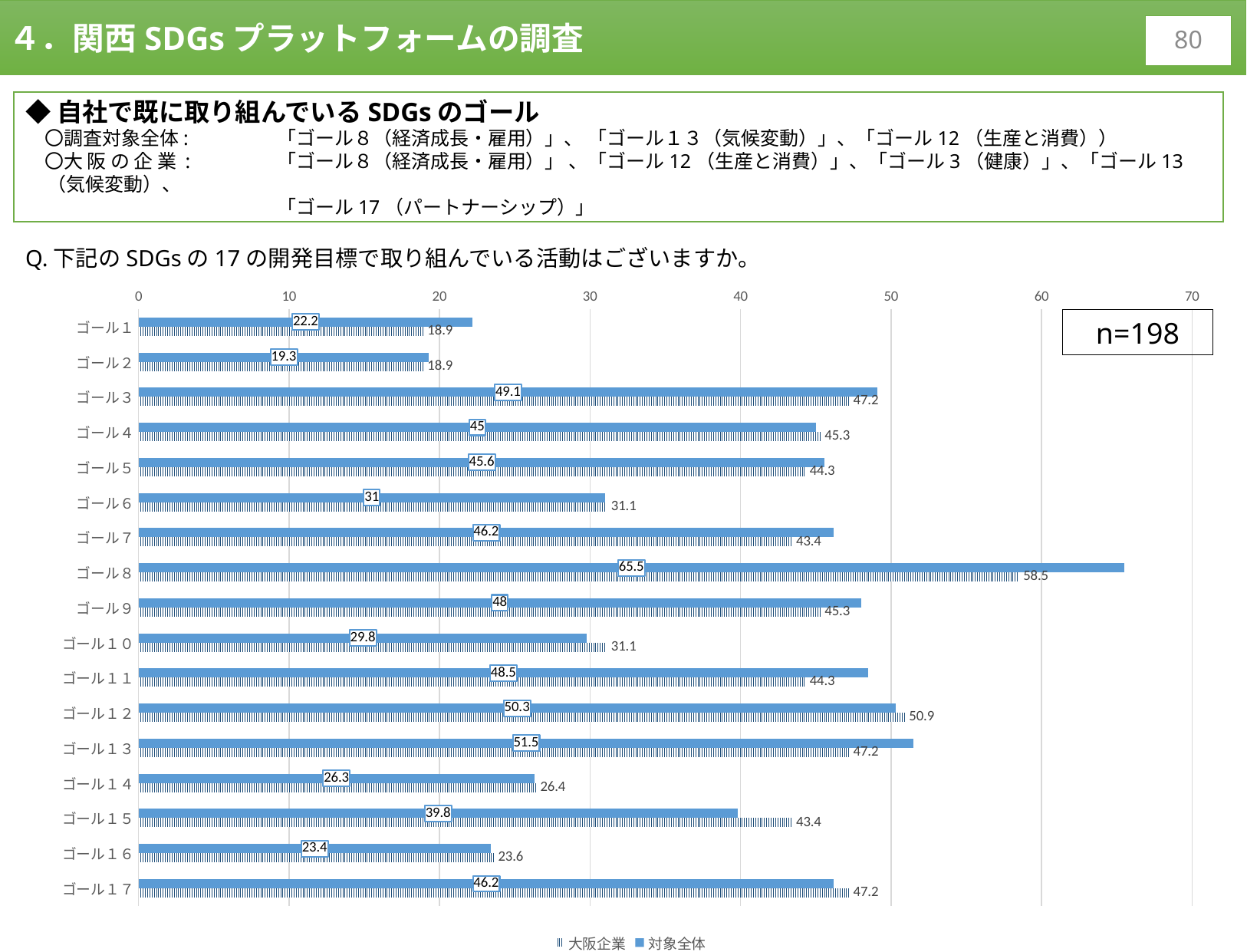
What is the value for 大阪企業 for ゴール１３? 47.2 For ゴール１５, which is larger: 大阪企業 or 対象全体? 大阪企業 What kind of chart is shown on the slide? bar chart How many goals (categories) are shown on the chart? 17 Which goal has the highest value for 対象全体? ゴール８ Which goal has the lowest value for 対象全体? ゴール２ What is the value for 対象全体 for ゴール８? 65.5 What is the difference between the 対象全体 and 大阪企業 values for ゴール８? 7 What is the value for 対象全体 for ゴール１５? 39.8 What sample size (n) is shown on the chart? n=198 What is the value for 大阪企業 for ゴール１２? 50.9 How many series does the legend list? 2